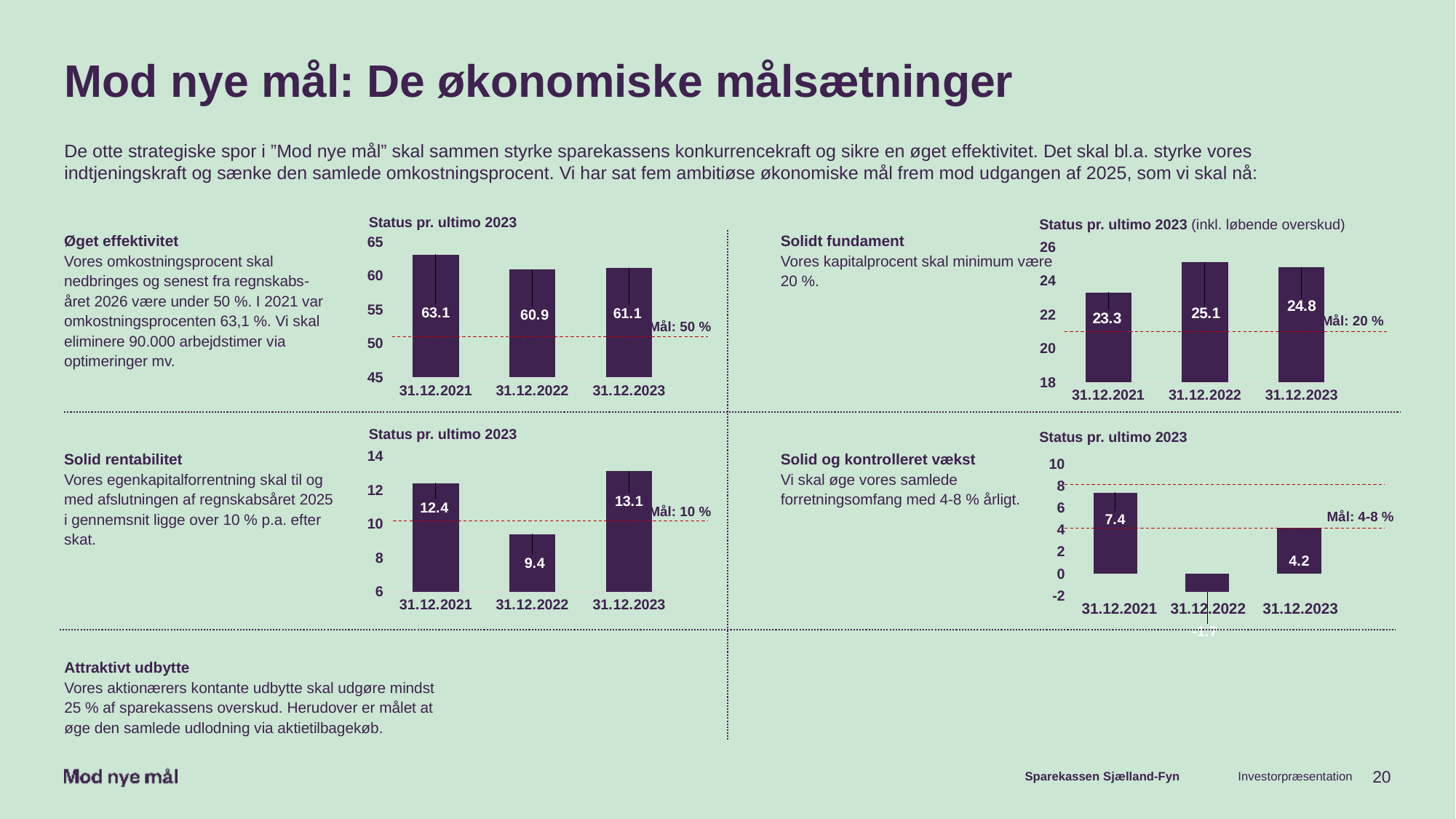
In the 'Øget effektivitet' chart (top left), which date has the lowest value? 31.12.2022 In the 'Solid rentabilitet' chart (bottom left), what is the difference between the values for 31.12.2023 and 31.12.2022? 3.7 In the 'Øget effektivitet' chart (top left), what is the value for 31.12.2021? 63.1 In the 'Solid og kontrolleret vækst' chart (bottom right), what is the value for 31.12.2021? 7.4 In the 'Solid og kontrolleret vækst' chart (bottom right), is the value for 31.12.2022 greater or less than 0? less In the 'Øget effektivitet' chart (top left), what is the difference between the values for 31.12.2021 and 31.12.2023? 2.0 How many bars are plotted in the 'Solid og kontrolleret vækst' chart (bottom right)? 3 In the 'Solid rentabilitet' chart (bottom left), which is larger, the value for 31.12.2021 or 31.12.2023? 31.12.2023 In the 'Solidt fundament' chart (top right), which date has the highest value? 31.12.2022 In the 'Solidt fundament' chart (top right), what target (Mål) is shown? Mål: 20 % In the 'Solid rentabilitet' chart (bottom left), what is the value for 31.12.2022? 9.4 In the 'Solidt fundament' chart (top right), what is the value for 31.12.2022? 25.1